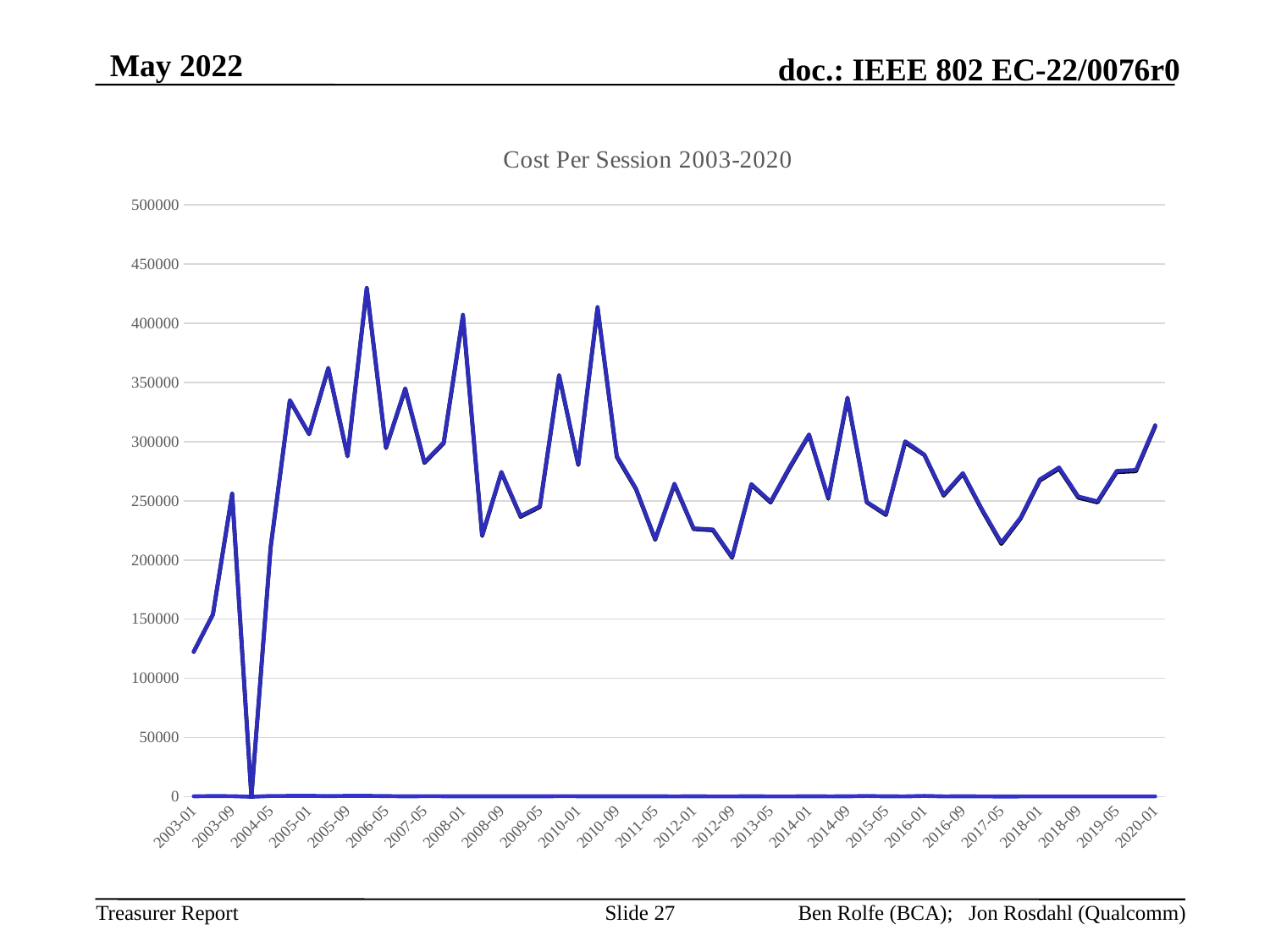
Is the value for 2003-09 greater or less than 200000? greater How many labels are shown on the x axis? 26 Is the value for 2003-01 greater or less than 100000? greater What kind of chart is shown on the slide? line chart Is the lowest value on the chart greater or less than 50000? less What is the title of the chart? Cost Per Session 2003-2020 What is the highest tick value shown on the y axis? 500000 Which is larger, the value for 2003-01 or the value for 2020-01? 2020-01